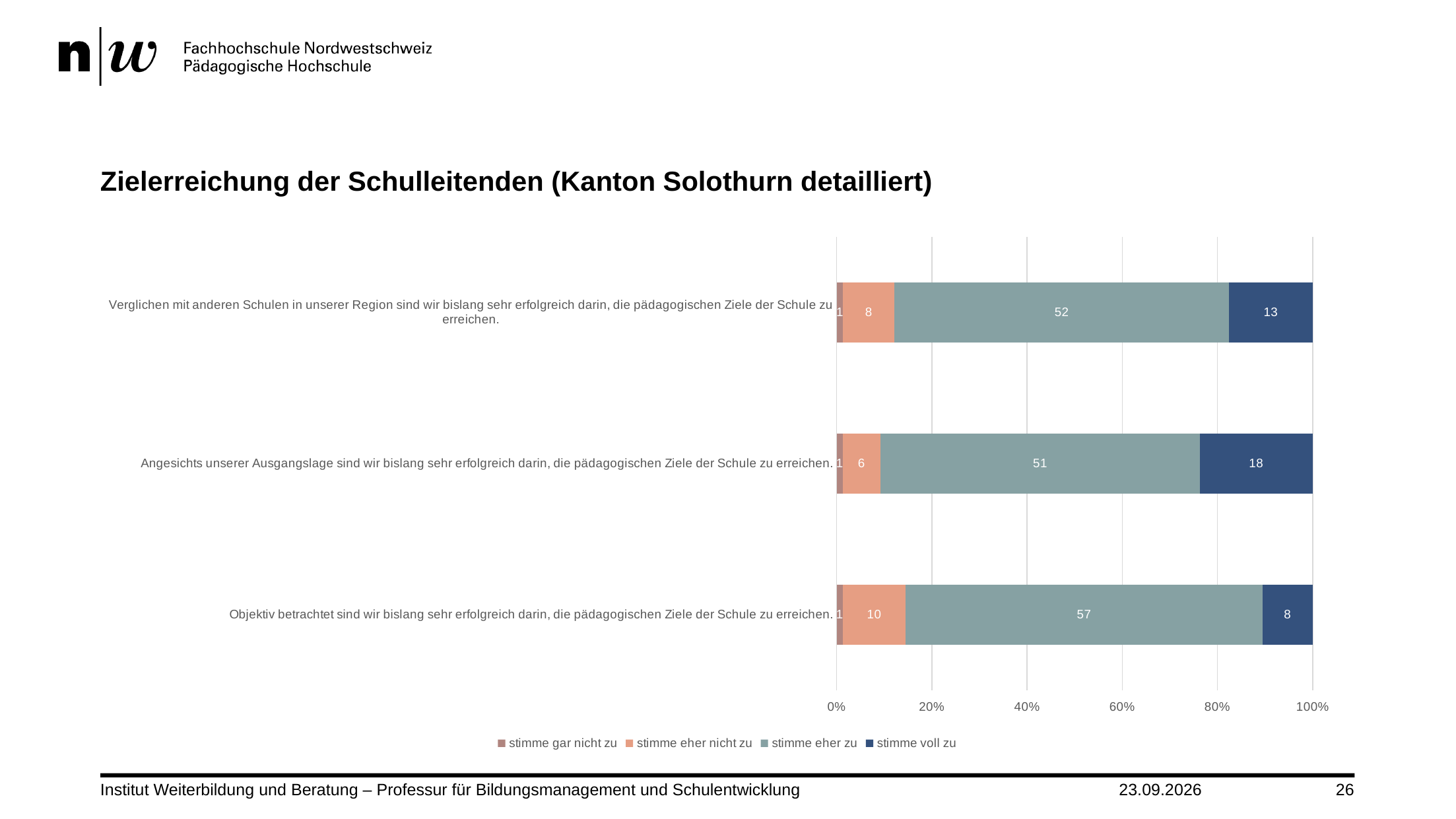
What is the value for "stimme eher nicht zu" for the statement "Verglichen mit anderen Schulen in unserer Region sind wir bislang sehr erfolgreich darin, die pädagogischen Ziele der Schule zu erreichen."? 8 What is the value for "stimme eher zu" for the statement "Objektiv betrachtet sind wir bislang sehr erfolgreich darin, die pädagogischen Ziele der Schule zu erreichen."? 57 How many series does the legend list? 4 Which is larger: the "stimme eher nicht zu" value for the "Objektiv betrachtet" statement or for the "Angesichts unserer Ausgangslage" statement? Objektiv betrachtet Which statement has the lowest value for "stimme voll zu"? Objektiv betrachtet sind wir bislang sehr erfolgreich darin, die pädagogischen Ziele der Schule zu erreichen. What is the value for "stimme gar nicht zu" for the statement "Angesichts unserer Ausgangslage sind wir bislang sehr erfolgreich darin, die pädagogischen Ziele der Schule zu erreichen."? 1 What is the title of the chart slide? Zielerreichung der Schulleitenden (Kanton Solothurn detailliert) What is the value for "stimme voll zu" for the statement "Angesichts unserer Ausgangslage sind wir bislang sehr erfolgreich darin, die pädagogischen Ziele der Schule zu erreichen."? 18 What is the difference between the "stimme eher zu" values for the "Objektiv betrachtet" statement and the "Angesichts unserer Ausgangslage" statement? 6 How many statements (categories) are plotted in the chart? 3 What kind of chart is shown on the slide? stacked bar chart Which statement has the highest value for "stimme voll zu"? Angesichts unserer Ausgangslage sind wir bislang sehr erfolgreich darin, die pädagogischen Ziele der Schule zu erreichen.